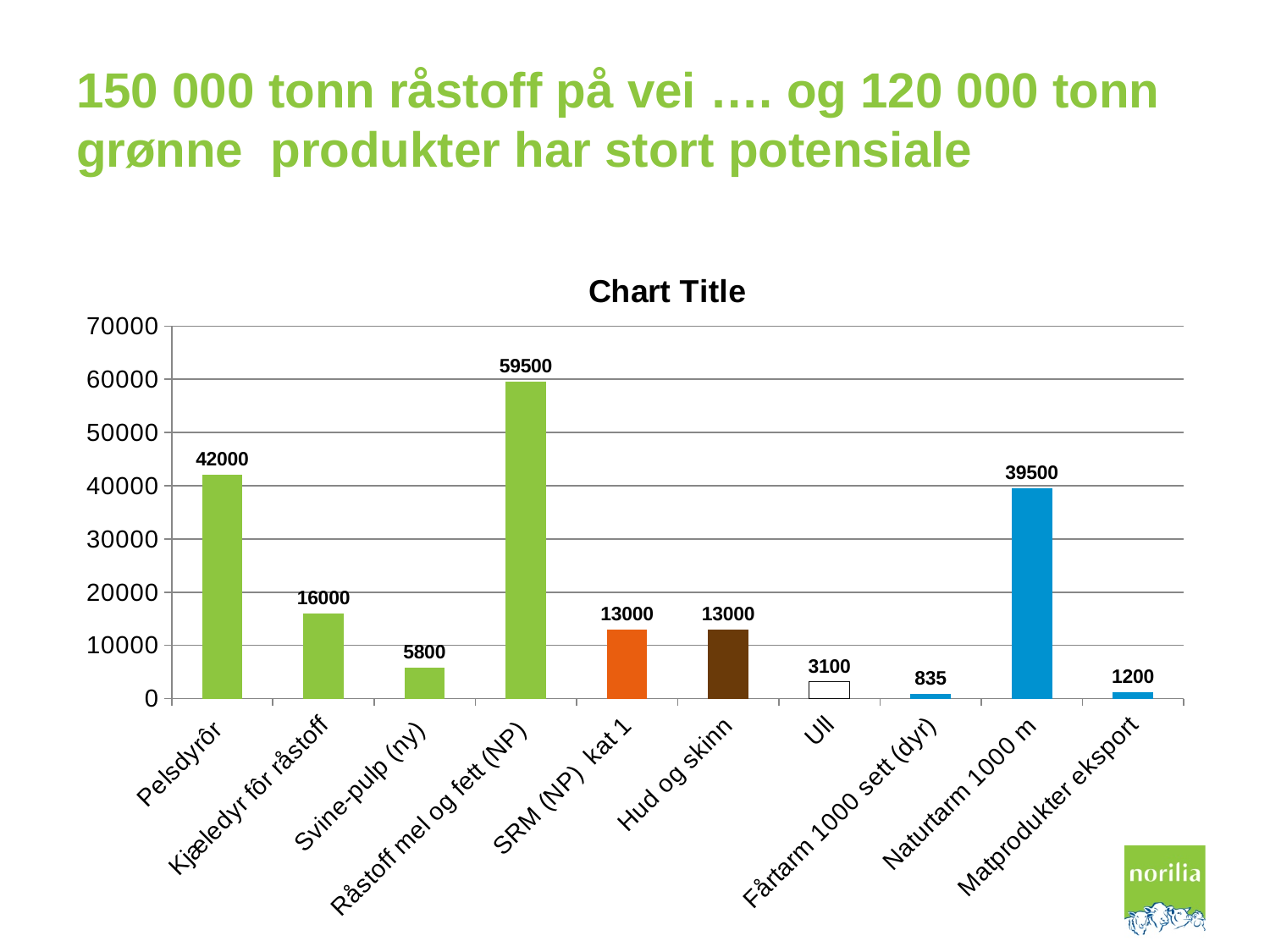
What is the difference between the values for Pelsdyrfôr and Kjæledyr fôr råstoff? 26000 How many categories are shown on the x axis? 10 What is the value for Pelsdyrfôr? 42000 Which category has the highest value? Råstoff mel og fett (NP) What is the title of the chart? Chart Title What kind of chart is shown on the slide? bar chart Is the value for Naturtarm 1000 m greater or less than 30000? greater What is the value for Fårtarm 1000 sett (dyr)? 835 Which category has the lowest value? Fårtarm 1000 sett (dyr) What is the value for Naturtarm 1000 m? 39500 What is the value for Råstoff mel og fett (NP)? 59500 Which is larger, the value for Svine-pulp (ny) or the value for Ull? Svine-pulp (ny)